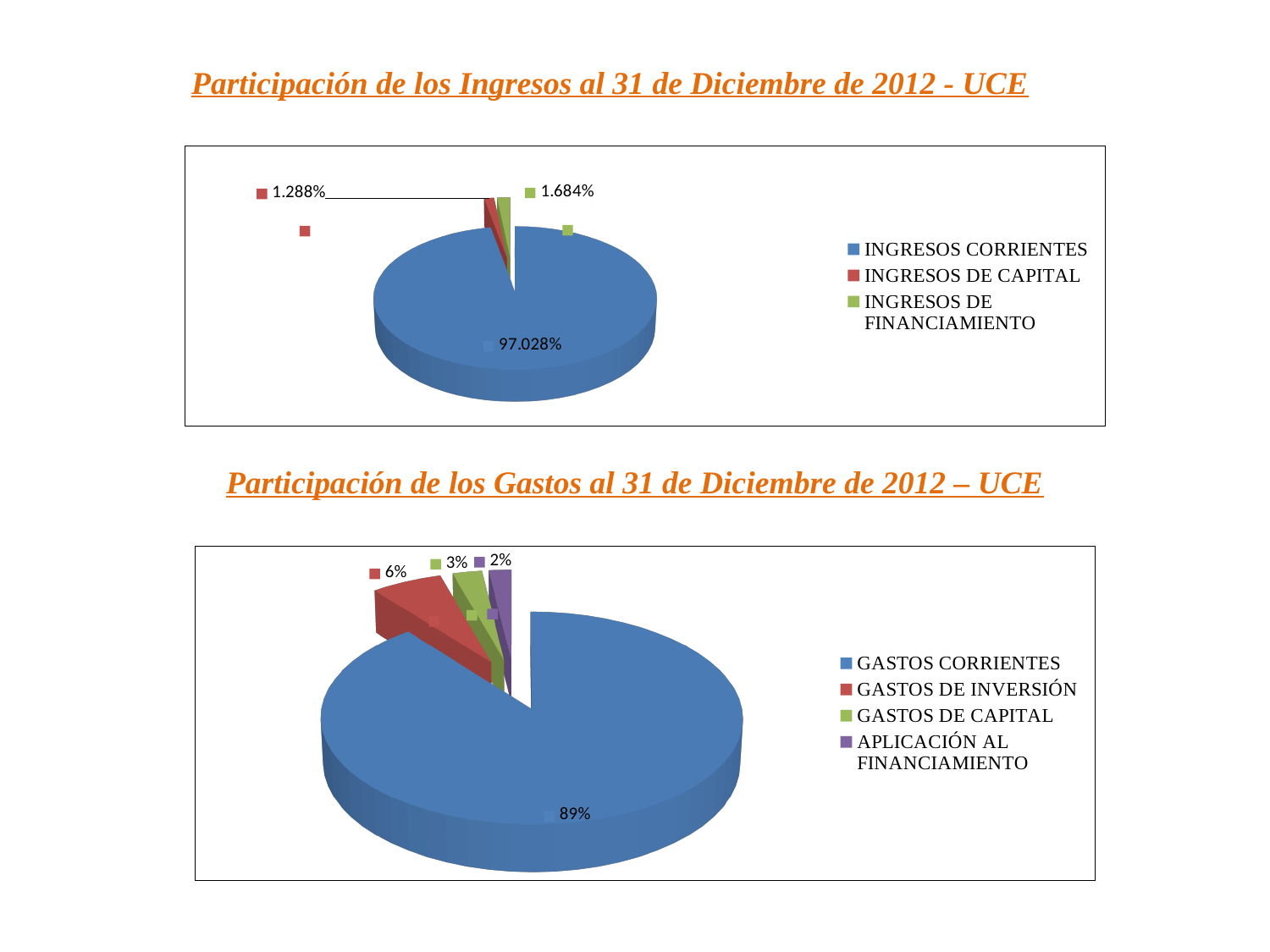
In the 'Participación de los Ingresos al 31 de Diciembre de 2012 - UCE' chart, what share does INGRESOS DE CAPITAL have? 1.288% In the 'Participación de los Ingresos al 31 de Diciembre de 2012 - UCE' chart, how many categories does the legend list? 3 What kind of chart is the 'Participación de los Ingresos al 31 de Diciembre de 2012 - UCE' chart? Pie chart In the 'Participación de los Gastos al 31 de Diciembre de 2012 – UCE' chart, how many categories does the legend list? 4 In the 'Participación de los Gastos al 31 de Diciembre de 2012 – UCE' chart, which category has the largest share? GASTOS CORRIENTES In the 'Participación de los Ingresos al 31 de Diciembre de 2012 - UCE' chart, which category has the smallest share? INGRESOS DE CAPITAL In the 'Participación de los Gastos al 31 de Diciembre de 2012 – UCE' chart, what share does APLICACIÓN AL FINANCIAMIENTO have? 2% In the 'Participación de los Ingresos al 31 de Diciembre de 2012 - UCE' chart, what share does INGRESOS DE FINANCIAMIENTO have? 1.684% In the 'Participación de los Gastos al 31 de Diciembre de 2012 – UCE' chart, what is the difference between the shares of GASTOS DE INVERSIÓN and GASTOS DE CAPITAL? 3% In the 'Participación de los Ingresos al 31 de Diciembre de 2012 - UCE' chart, what share does INGRESOS CORRIENTES have? 97.028% In the 'Participación de los Gastos al 31 de Diciembre de 2012 – UCE' chart, what share does GASTOS CORRIENTES have? 89% In the 'Participación de los Gastos al 31 de Diciembre de 2012 – UCE' chart, what share does GASTOS DE INVERSIÓN have? 6%